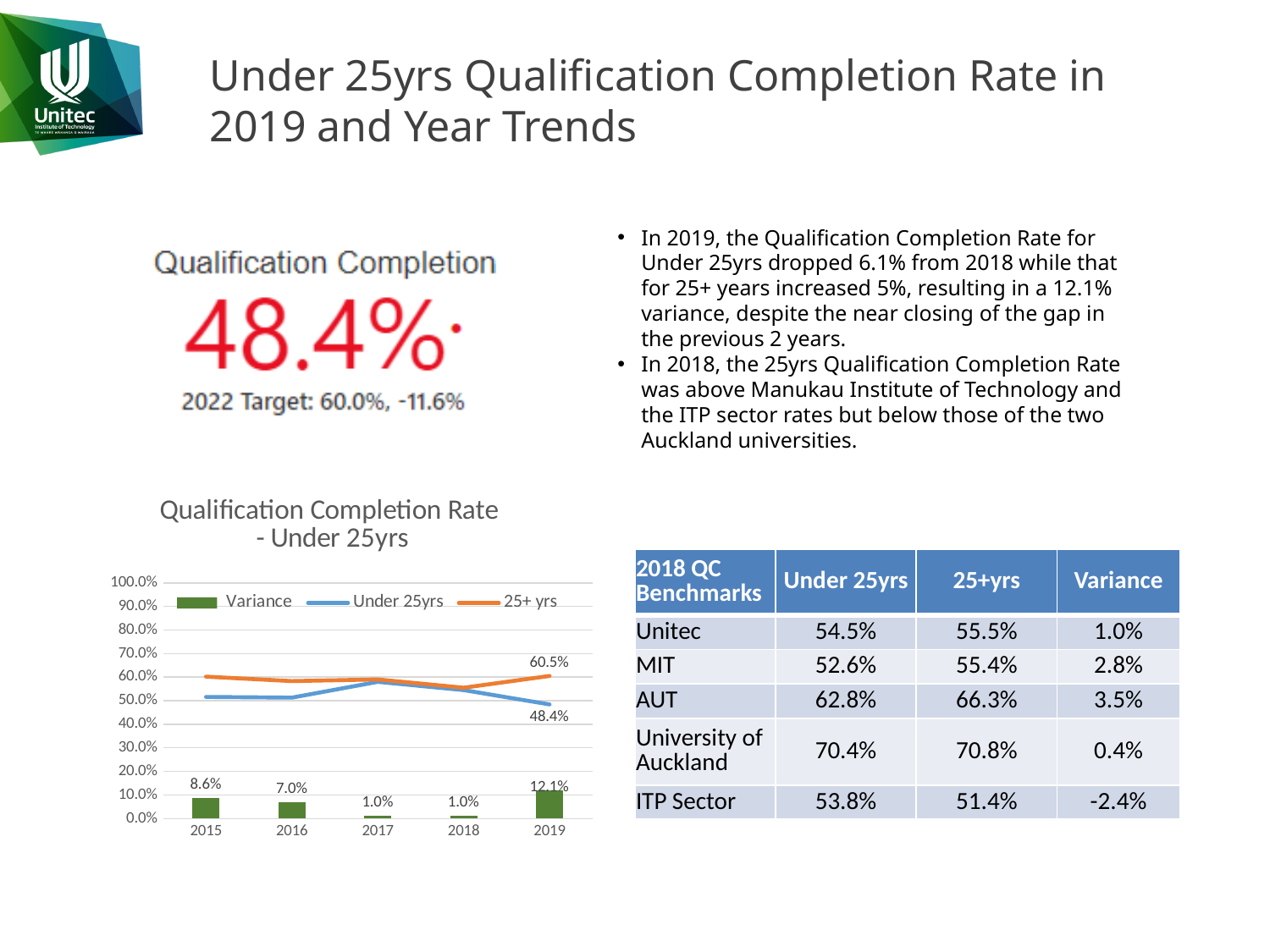
What is the difference between the Variance values for 2019 and 2015? 3.5% Does the Under 25yrs line rise or fall from 2017 to 2019? Fall What is the Under 25yrs value for 2019 in the chart? 48.4% What is the Variance value for 2019 in the Qualification Completion Rate - Under 25yrs chart? 12.1% In which year is the Variance bar highest? 2019 What kind of chart is the Qualification Completion Rate - Under 25yrs chart? Combined bar and line chart Is the Under 25yrs value for 2017 greater or less than 50.0%? greater Which year has the larger Variance value, 2015 or 2016? 2015 How many series does the chart's legend list? 3 How many years are shown on the x axis of the chart? 5 What is the 25+ yrs value for 2019 in the chart? 60.5% What is the Variance value for 2015 in the chart? 8.6%